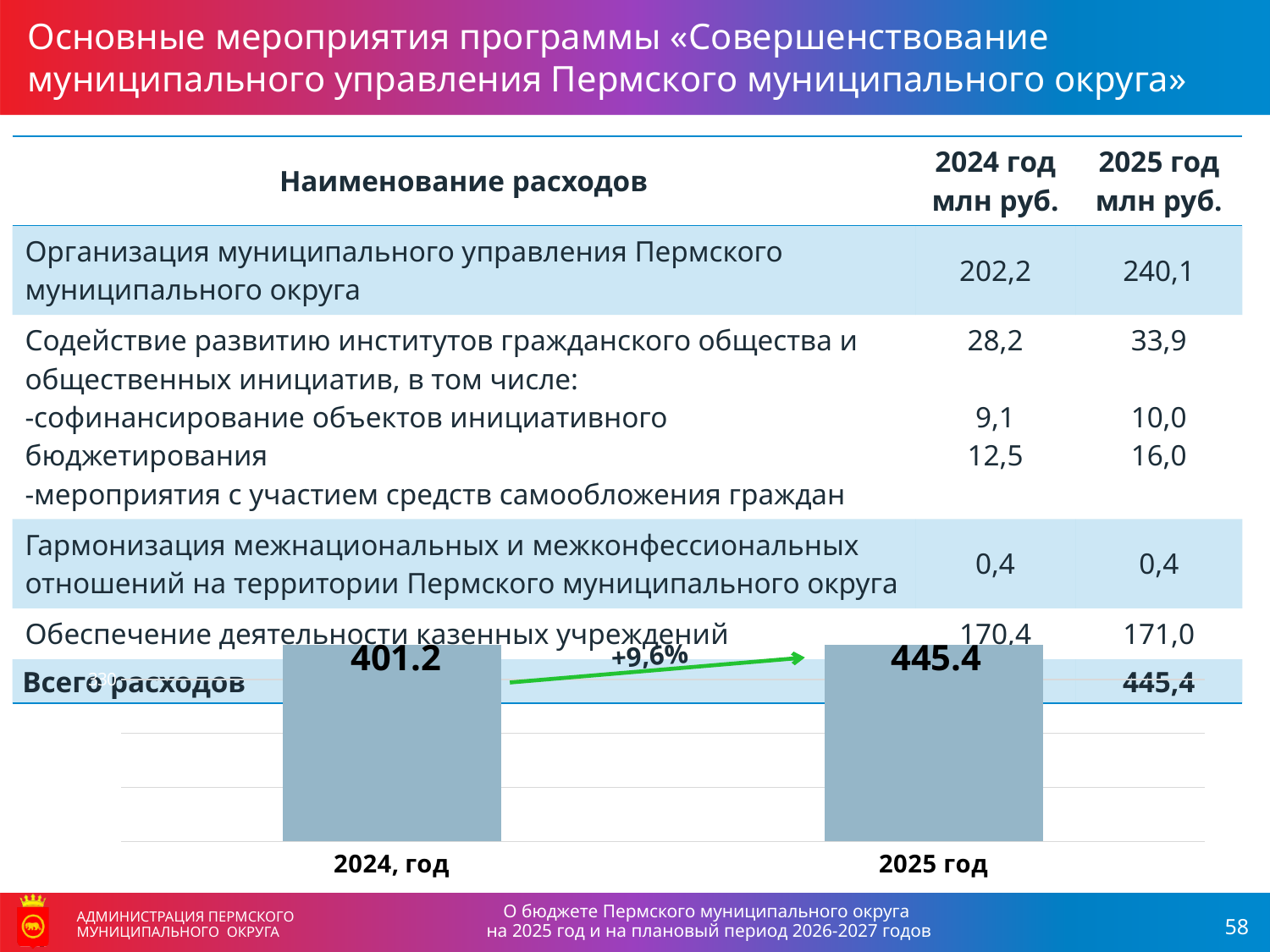
What is the difference between the 2025 value and the 2024 value in the chart? 44.2 What are the two category labels on the x axis of the chart? 2024, год and 2025 год What is the value shown for the 2025 bar in the chart? 445.4 Do the values in the chart rise or fall from 2024 to 2025? rise Which year has the lower bar in the chart? 2024, год Is the value for 2025 larger or smaller than the value for 2024 in the chart? larger What percentage change is written next to the arrow between the two bars in the chart? +9,6% What type of chart is shown at the bottom of the slide? bar chart What is the value shown for the 2024 bar in the chart? 401.2 Which year has the higher bar in the chart? 2025 год How many bars are plotted in the chart? 2